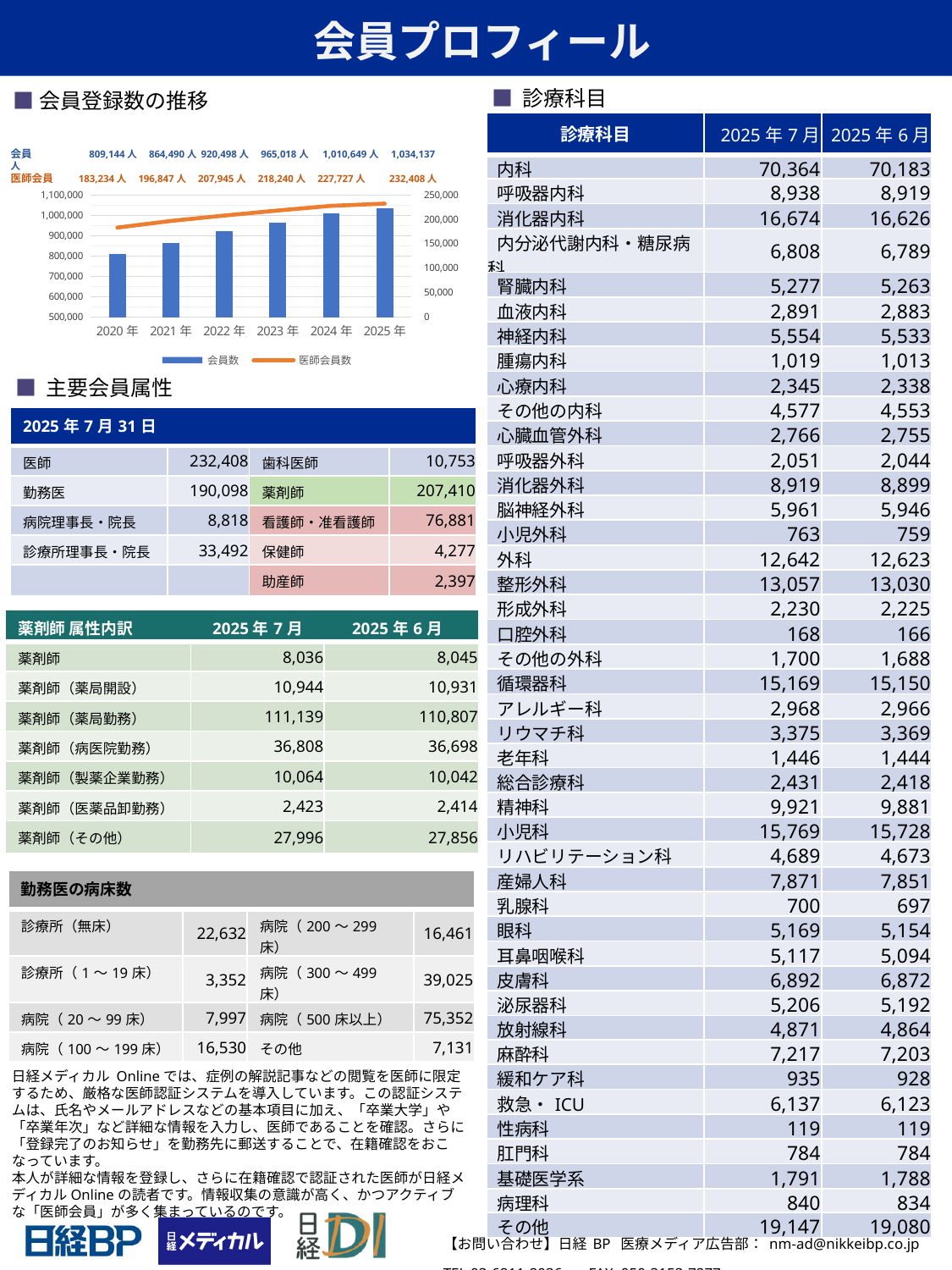
In the 会員登録数の推移 chart, what is the difference between the 医師会員 values for 2025年 and 2024年? 4,681人 In the 会員登録数の推移 chart, what is the 会員 value for 2025年? 1,034,137 In the 会員登録数の推移 chart, what is the difference between the 会員 values for 2021年 and 2020年? 55,346人 In the 会員登録数の推移 chart, which year has the lowest 医師会員数? 2020年 How many years are shown on the x axis of the 会員登録数の推移 chart? 6 In the 会員登録数の推移 chart, what kind of chart is used to show 会員数? bar chart In the 会員登録数の推移 chart, what is the 会員 value for 2022年? 920,498人 In the 会員登録数の推移 chart, what is the 医師会員 value for 2024年? 227,727人 In the 会員登録数の推移 chart, do the 医師会員数 values rise or fall from 2020年 to 2025年? rise In the 会員登録数の推移 chart, which year has the larger 会員数, 2023年 or 2024年? 2024年 How many series does the legend of the 会員登録数の推移 chart list? 2 In the 会員登録数の推移 chart, which year has the highest 会員数? 2025年